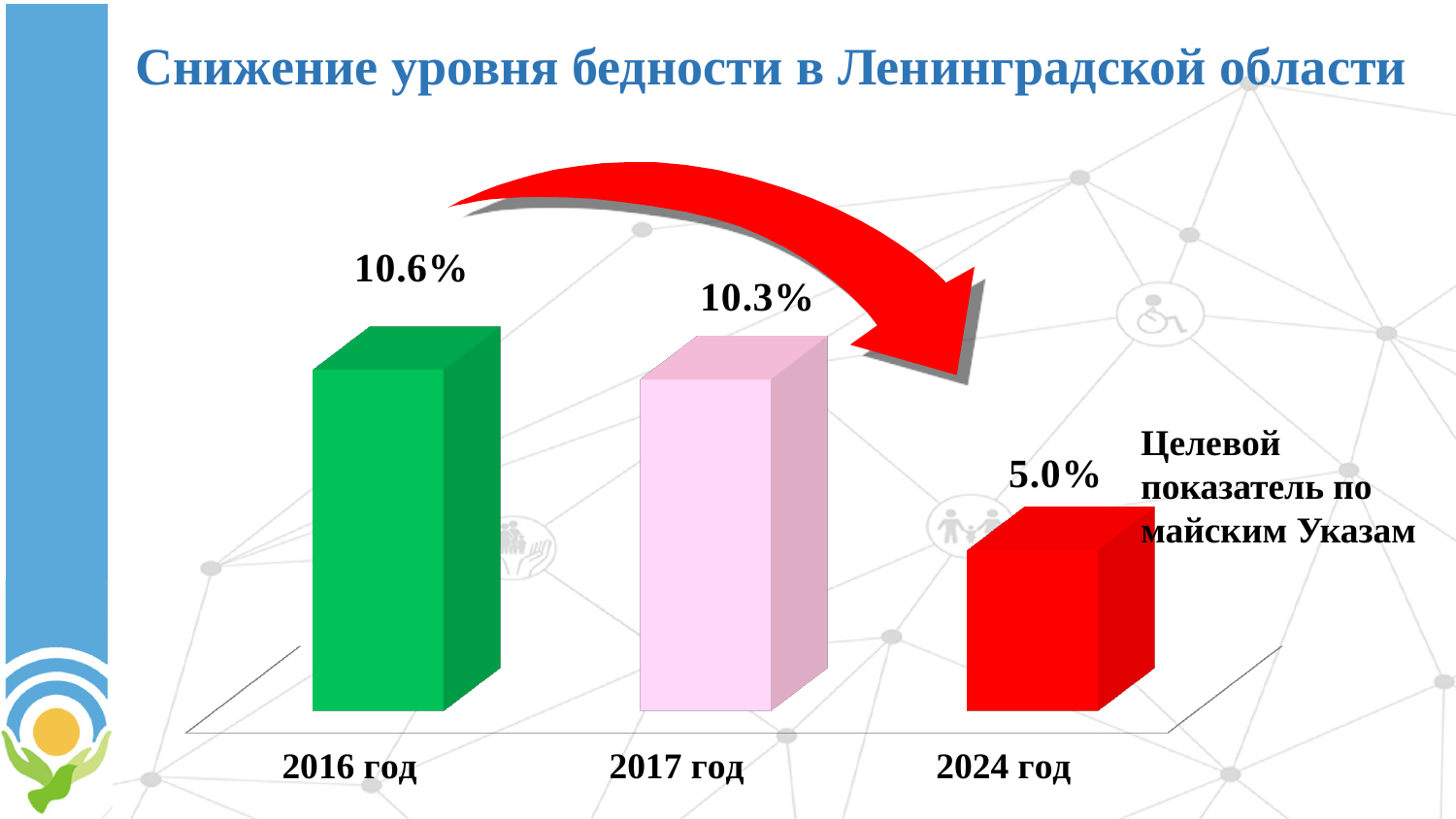
What is the difference between the values for 2016 год and 2017 год? 0.3% What is the value shown for 2024 год? 5.0% Do the values rise or fall from 2016 год to 2024 год? Fall What is the poverty level shown for 2016 год? 10.6% What is the poverty level shown for 2017 год? 10.3% What is the difference between the values for 2016 год and 2024 год? 5.6% Which year has the lowest value on the chart? 2024 год What is the title of the chart on the slide? Снижение уровня бедности в Ленинградской области How many years (categories) are shown on the chart? 3 Which year has the highest value on the chart? 2016 год Which is larger, the value for 2017 год or the value for 2024 год? 2017 год What kind of chart is shown on the slide? Bar chart